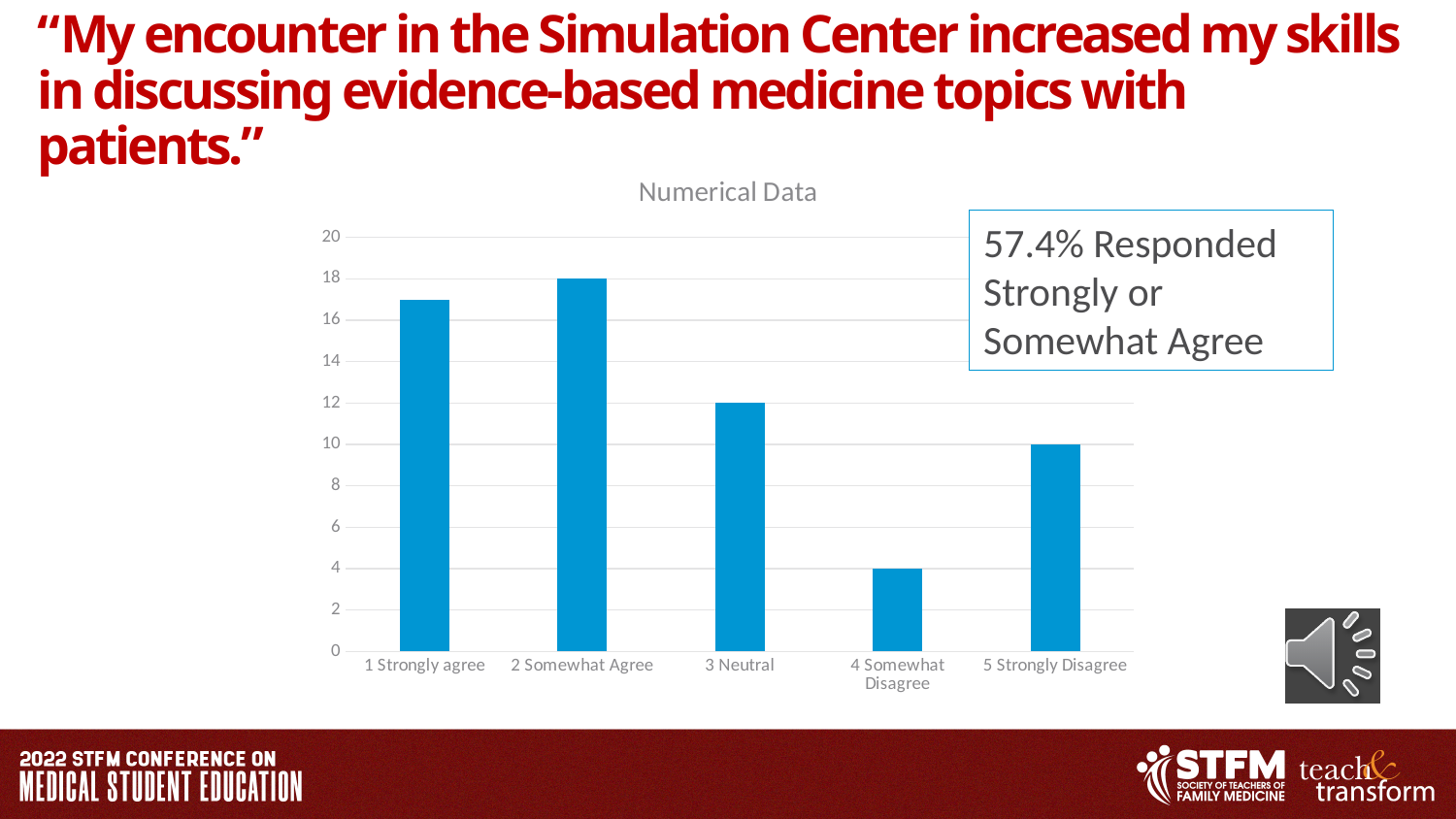
How many categories are shown on the x axis of the chart? 5 What type of chart is shown on the slide? Bar chart What is the value for 3 Neutral? 12 Which category has the lowest value? 4 Somewhat Disagree What is the value for 5 Strongly Disagree? 10 What is the value for 4 Somewhat Disagree? 4 What is the value for 2 Somewhat Agree? 18 Is the value for 1 Strongly agree greater or less than 16? greater Which category has the highest value? 2 Somewhat Agree What is the difference between the values for 2 Somewhat Agree and 3 Neutral? 6 Which is larger, the value for 3 Neutral or the value for 5 Strongly Disagree? 3 Neutral What is the title of the chart? Numerical Data